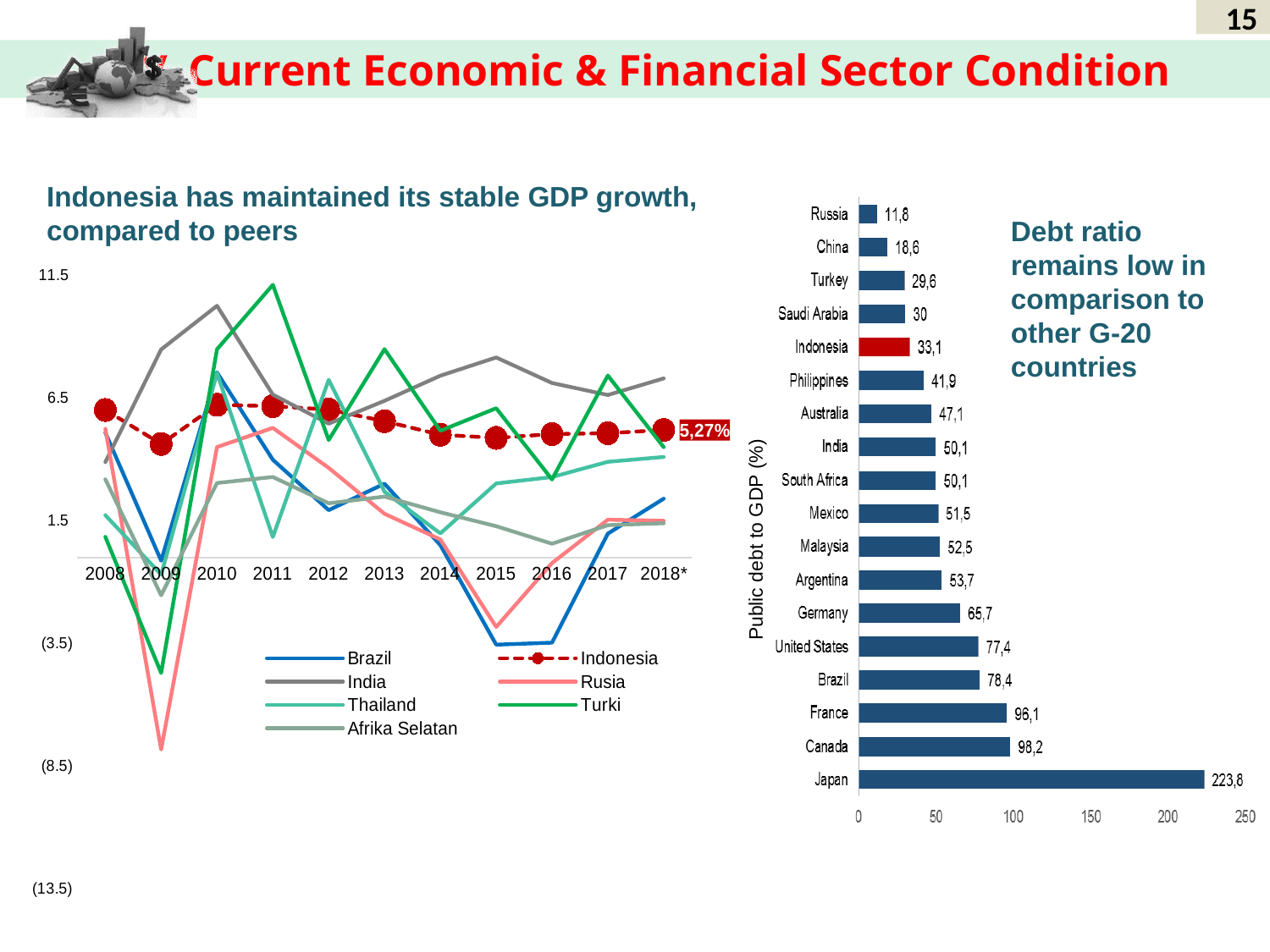
In the line chart on the left, what value is labelled for Indonesia at 2018*? 5,27% What kind of chart is the chart on the right showing public debt to GDP? bar chart How many series does the legend of the line chart on the left list? 7 In the bar chart on the right, which country has the lowest public debt to GDP? Russia In the bar chart on the right, what is the difference between Canada's and France's public debt to GDP values? 2,1 In the bar chart on the right, is the value for United States greater or less than 50? greater In the bar chart on the right, how many countries are shown? 18 In the bar chart on the right, which has a higher public debt to GDP, Germany or Mexico? Germany In the bar chart on the right, which country has the highest public debt to GDP? Japan In the line chart on the left, how many years are shown on the x axis? 11 In the bar chart on the right, what is the public debt to GDP value for Indonesia? 33,1 In the bar chart on the right, what is the public debt to GDP value for Japan? 223,8